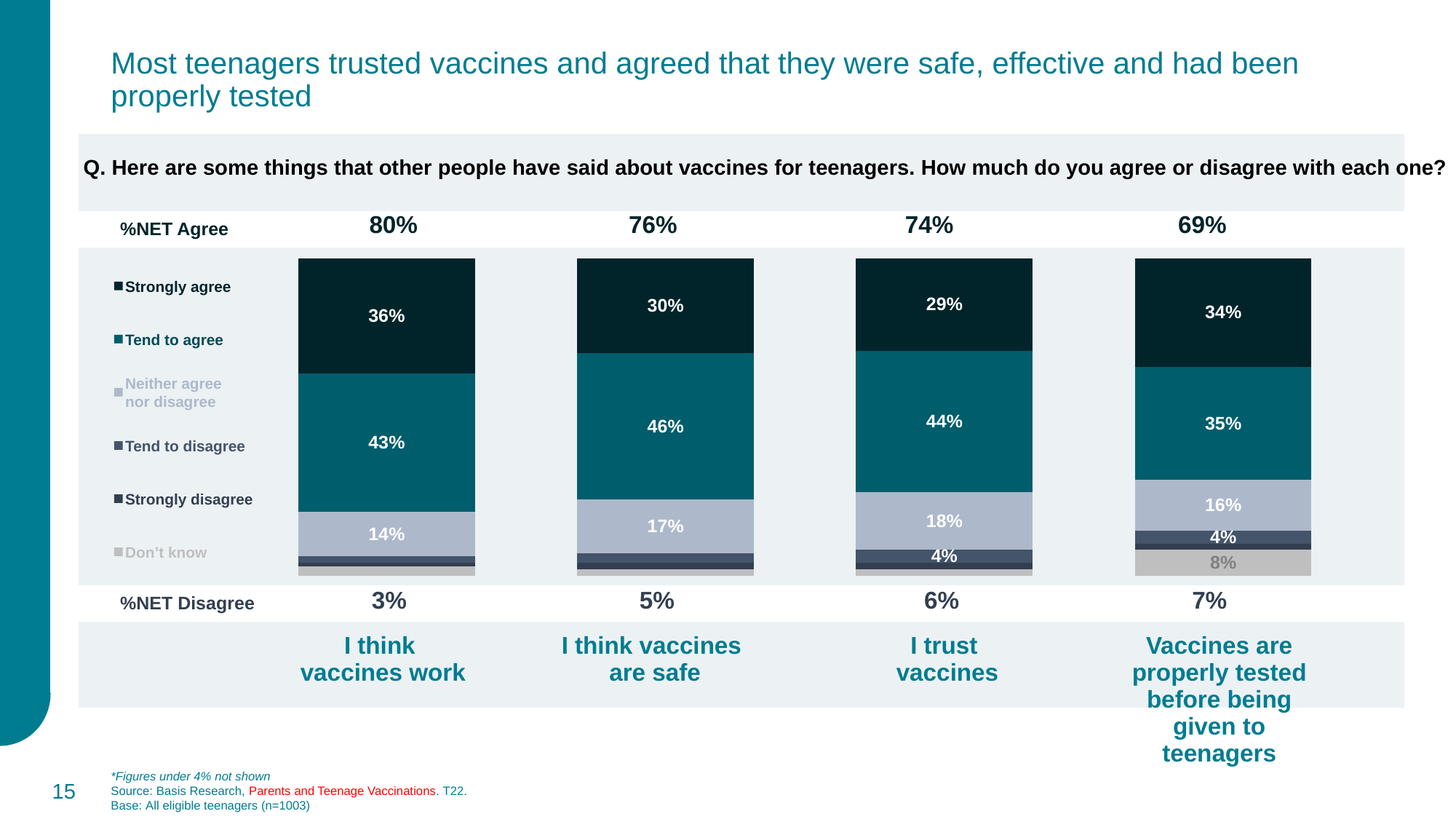
Which statement has the highest %NET Agree? I think vaccines work What kind of chart is shown on the slide? Stacked bar chart What percentage answered 'Don't know' for 'Vaccines are properly tested before being given to teenagers'? 8% Do the %NET Agree values rise or fall moving from left to right across the statements? Fall How many series does the legend list? 6 How many statements (categories) are plotted on the chart? 4 What percentage of teenagers tend to agree with 'I think vaccines are safe'? 46% What is the %NET Agree value for 'I trust vaccines'? 74% Which is larger: the 'Tend to agree' share for 'I think vaccines work' or for 'Vaccines are properly tested before being given to teenagers'? I think vaccines work What is the difference between the %NET Agree for 'I think vaccines work' and for 'Vaccines are properly tested before being given to teenagers'? 11% What percentage of teenagers strongly agree with 'I think vaccines work'? 36% Which statement has the lowest %NET Disagree? I think vaccines work